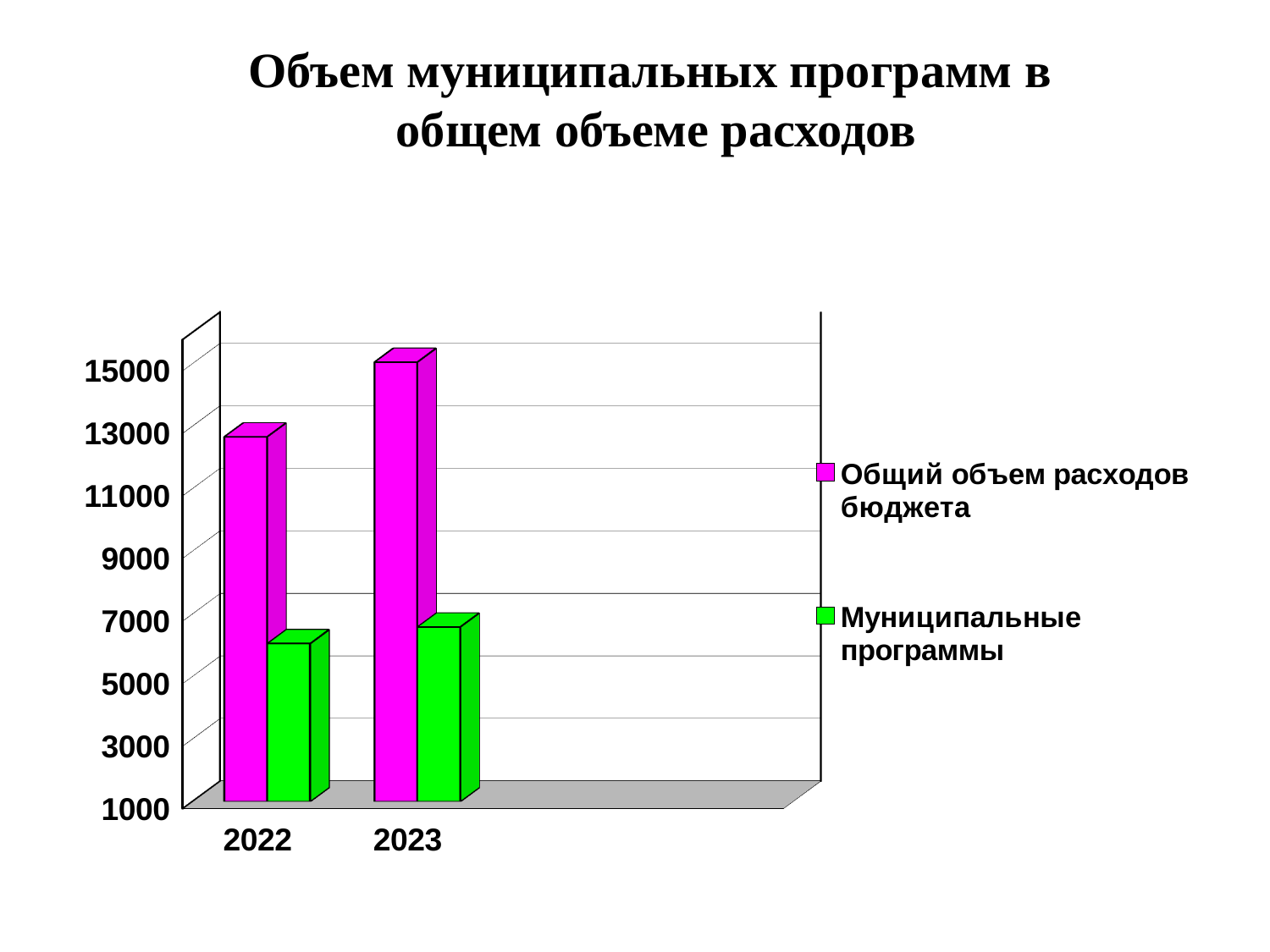
Does the value for Общий объем расходов бюджета rise or fall from 2022 to 2023? rise Is the value for Общий объем расходов бюджета in 2022 greater or less than 11000? greater Is the value for Общий объем расходов бюджета in 2023 greater or less than 13000? greater What is the title of the chart? Объем муниципальных программ в общем объеме расходов What kind of chart is shown on the slide? bar chart Is the value for Муниципальные программы in 2023 greater or less than 9000? less Which year has the higher value for Общий объем расходов бюджета? 2023 Which series is shown in green? Муниципальные программы How many series does the legend list? 2 How many categories are shown on the x axis? 2